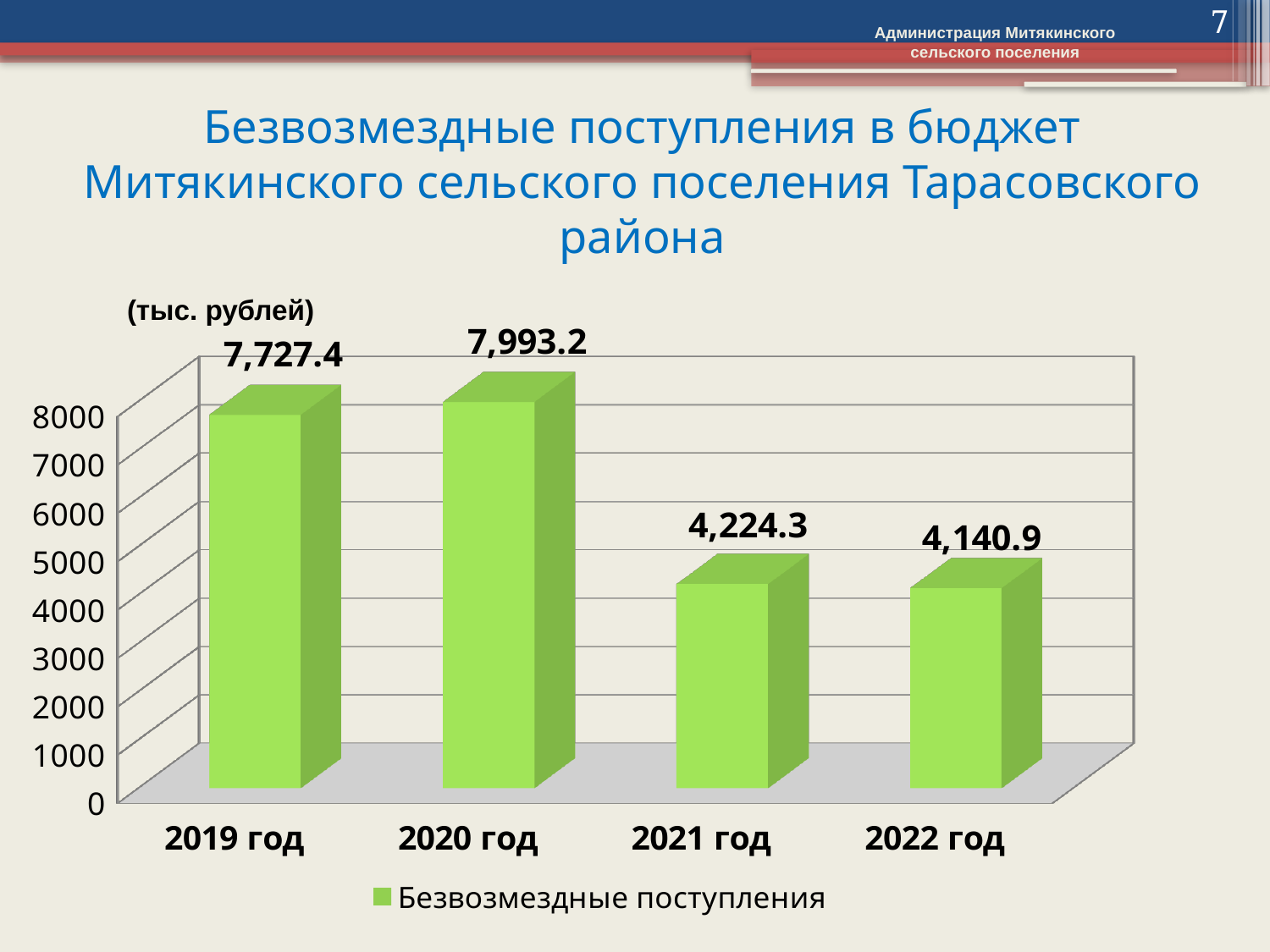
Which year has the highest value? 2020 год How many years are shown on the chart? 4 Is the value for 2021 год greater or less than 4000? greater Which is larger, the value for 2019 год or the value for 2020 год? 2020 год What is the difference between the values for 2021 год and 2022 год? 83.4 What is the value for 2019 год? 7,727.4 What is the value for 2022 год? 4,140.9 What is the value for 2021 год? 4,224.3 What series name does the legend show? Безвозмездные поступления Which year has the lowest value? 2022 год What is the difference between the values for 2020 год and 2019 год? 265.8 What kind of chart is shown on the slide? bar chart